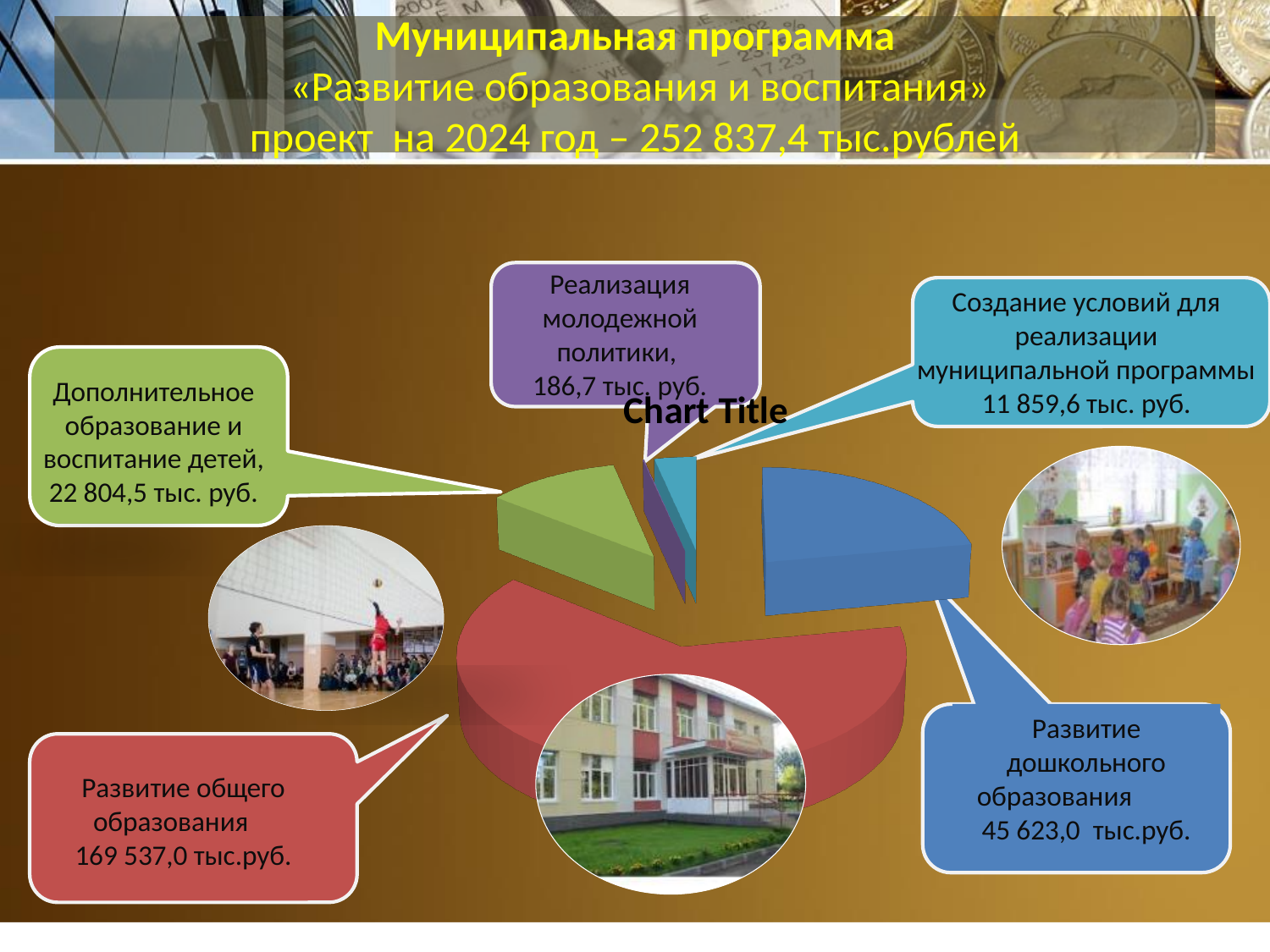
What is the value for «Развитие дошкольного образования»? 45 623,0 тыс.руб. Which category has the largest slice of the pie? Развитие общего образования What is the difference between «Развитие общего образования» and «Развитие дошкольного образования»? 123 914,0 тыс.руб. What is the value for «Развитие общего образования»? 169 537,0 тыс.руб. What colour is the slice for «Развитие общего образования»? red What is the value for «Реализация молодежной политики»? 186,7 тыс. руб. Which is larger: «Развитие дошкольного образования» or «Дополнительное образование и воспитание детей»? Развитие дошкольного образования Which category has the smallest slice of the pie? Реализация молодежной политики What is the value for «Дополнительное образование и воспитание детей»? 22 804,5 тыс. руб. What kind of chart is shown on the slide? pie chart How many slices does the pie chart have? 5 What is the value for «Создание условий для реализации муниципальной программы»? 11 859,6 тыс. руб.